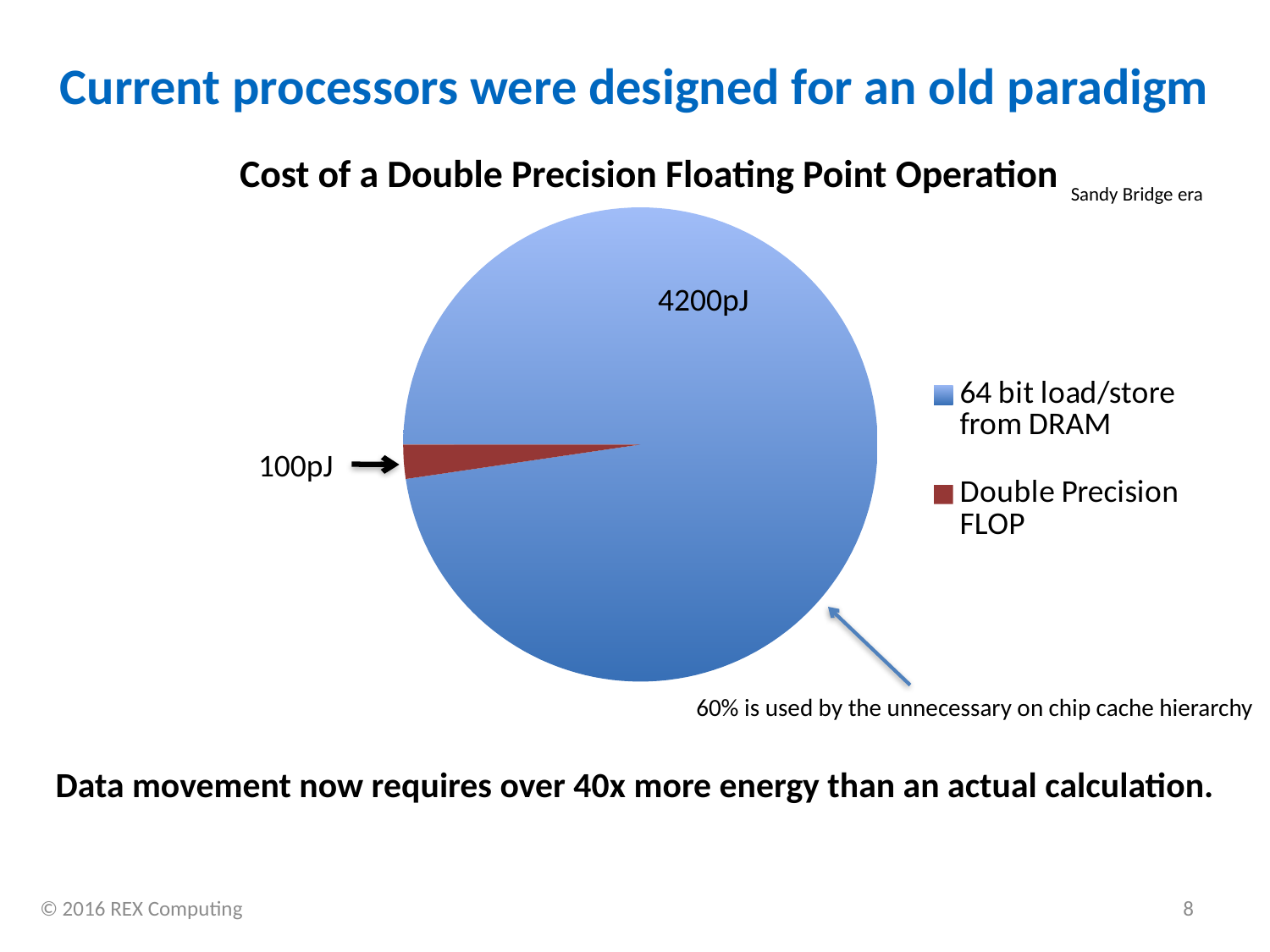
What kind of chart is shown on the slide? Pie chart What is the difference between the 64 bit load/store from DRAM value and the Double Precision FLOP value? 4100pJ How many entries does the legend list? 2 What is the value shown for the Double Precision FLOP slice? 100pJ Which is larger, the value for 64 bit load/store from DRAM or the value for Double Precision FLOP? 64 bit load/store from DRAM What is the total of the two values shown in the pie chart? 4300pJ What is the title of the chart? Cost of a Double Precision Floating Point Operation What colour is the Double Precision FLOP slice? Red Which category has the largest slice of the pie? 64 bit load/store from DRAM Which category has the smallest slice of the pie? Double Precision FLOP What is the value shown for the 64 bit load/store from DRAM slice? 4200pJ How many slices does the pie chart have? 2